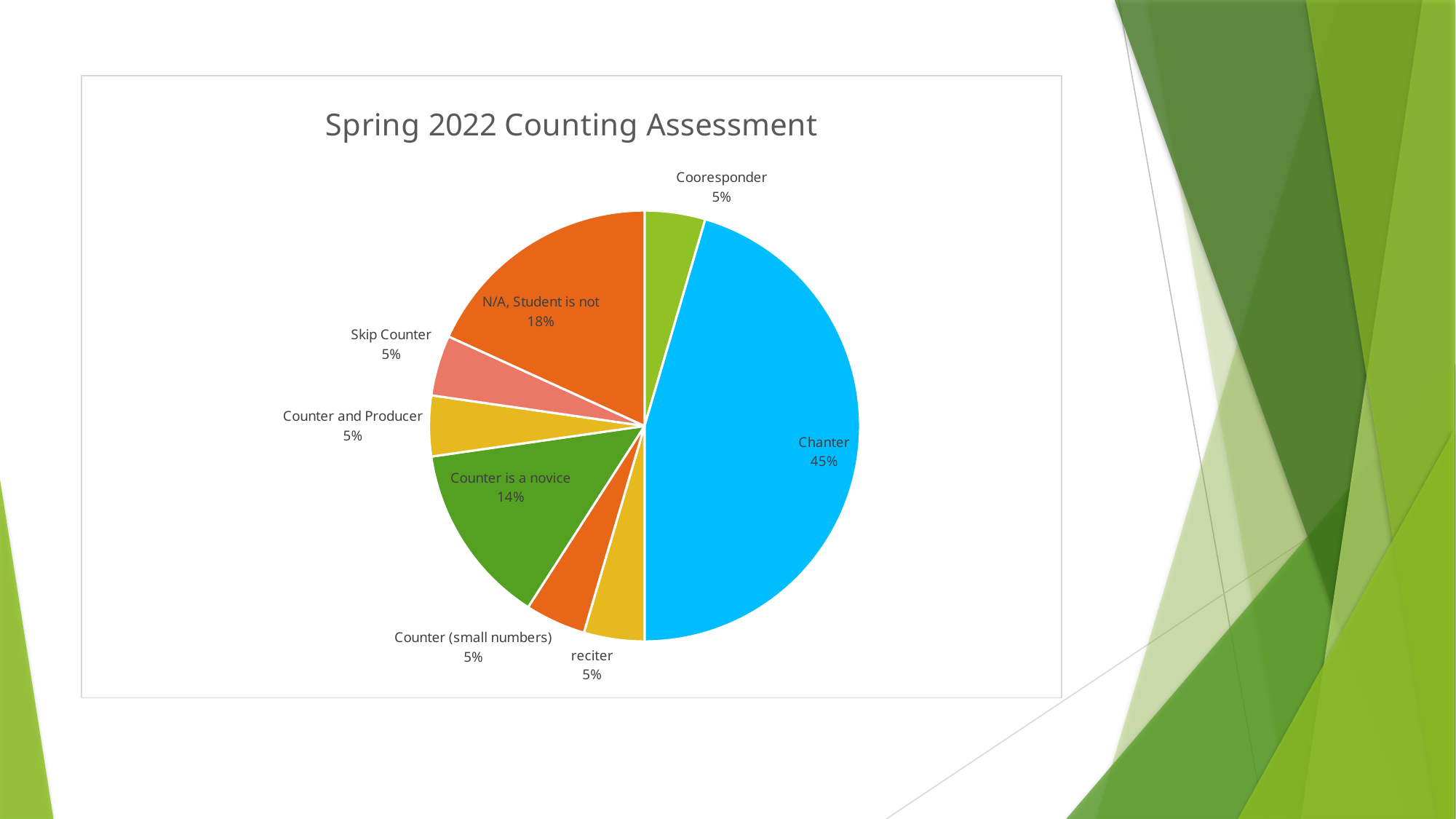
What share of the pie does N/A, Student is not represent? 18% What colour is the Chanter slice? blue What share of the pie does Skip Counter represent? 5% What is the title of the chart? Spring 2022 Counting Assessment What share of the pie does Chanter represent? 45% Which category has the largest slice of the pie? Chanter How many slices does the pie chart have? 8 What is the difference between the Chanter share and the N/A, Student is not share? 27% What is the combined share of Chanter and Counter is a novice? 59% What kind of chart is shown on the slide? pie chart Which is larger, the share for Counter is a novice or the share for N/A, Student is not? N/A, Student is not